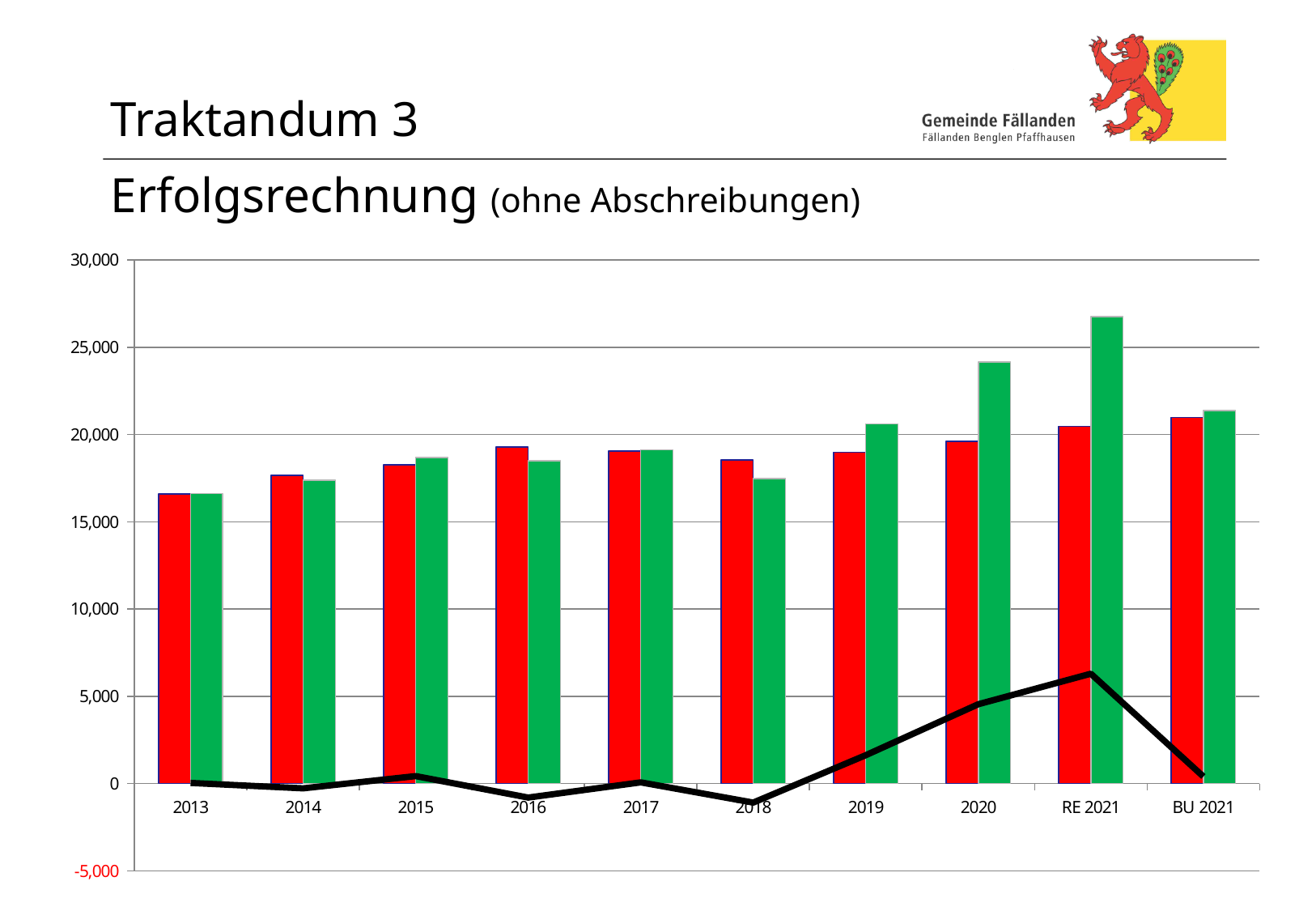
For 2016, which bar is larger, the red bar or the green bar? red bar What kind of chart is shown on the slide? Bar chart with a line In which category is the red bar the highest? BU 2021 In which category is the red bar the lowest? 2013 What is the title of the chart on the slide? Erfolgsrechnung (ohne Abschreibungen) In which category is the green bar the highest? RE 2021 How many categories are shown on the x axis of the chart? 10 Is the green bar for RE 2021 greater or less than 25,000? greater Is the green bar for 2018 greater or less than 20,000? less For 2020, which bar is larger, the red bar or the green bar? green bar Is the black line value for RE 2021 greater or less than 5,000? greater In which category does the black line reach its highest point? RE 2021